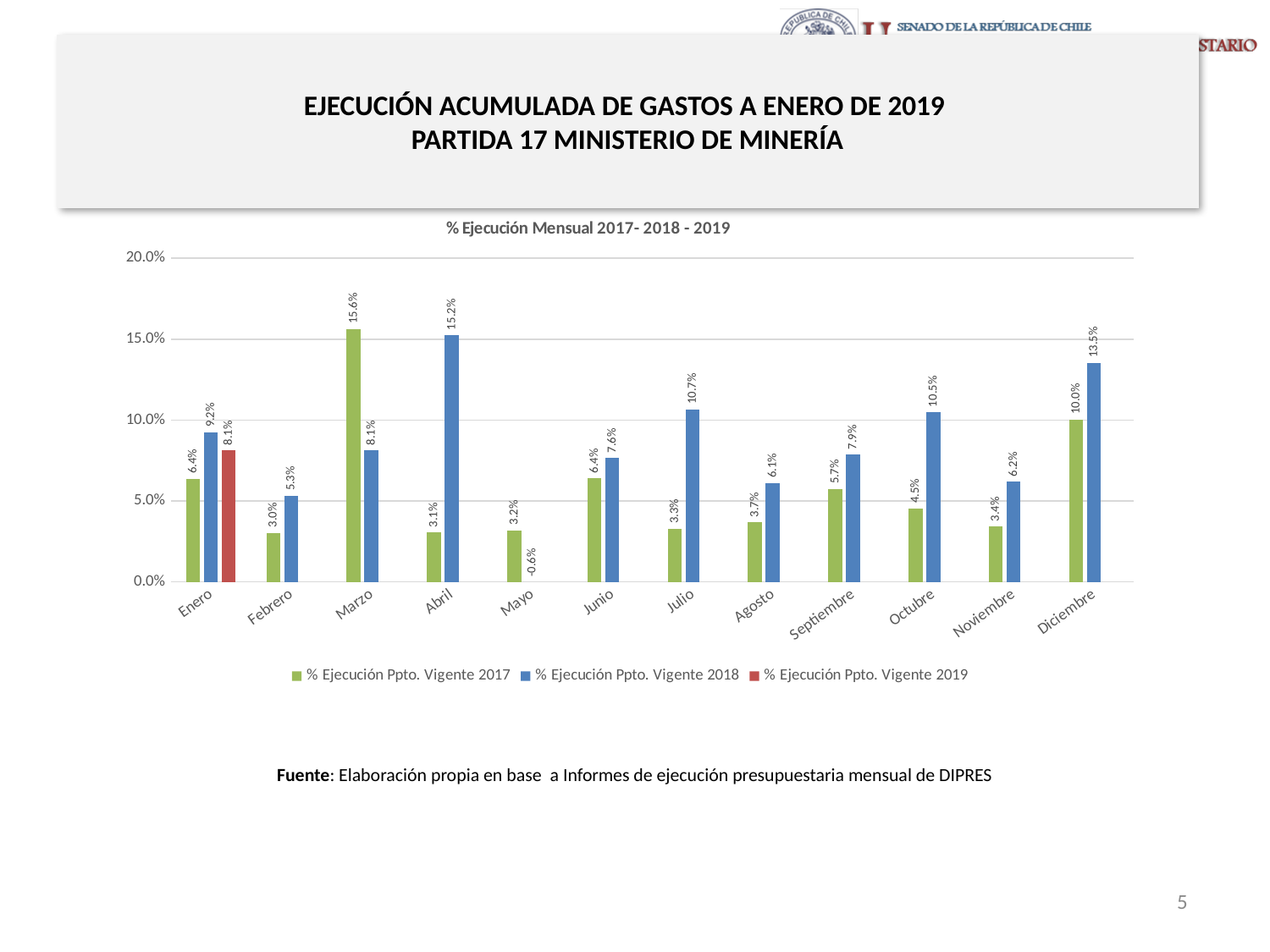
What is the value for % Ejecución Ppto. Vigente 2018 in Abril? 15.2% Which is larger in Marzo, the 2017 value or the 2018 value? 2017 How many series does the legend list? 3 In which month is the % Ejecución Ppto. Vigente 2017 value highest? Marzo How many months are shown on the x axis? 12 What is the value for % Ejecución Ppto. Vigente 2017 in Mayo? 3.2% What is the difference between the 2018 and 2017 values in Diciembre? 3.5% What is the difference between the 2018 and 2019 values in Enero? 1.1% What is the title of the chart? % Ejecución Mensual 2017- 2018 - 2019 What type of chart is shown on the slide? bar chart In which month is the % Ejecución Ppto. Vigente 2018 value lowest? Mayo What is the value for % Ejecución Ppto. Vigente 2019 in Enero? 8.1%